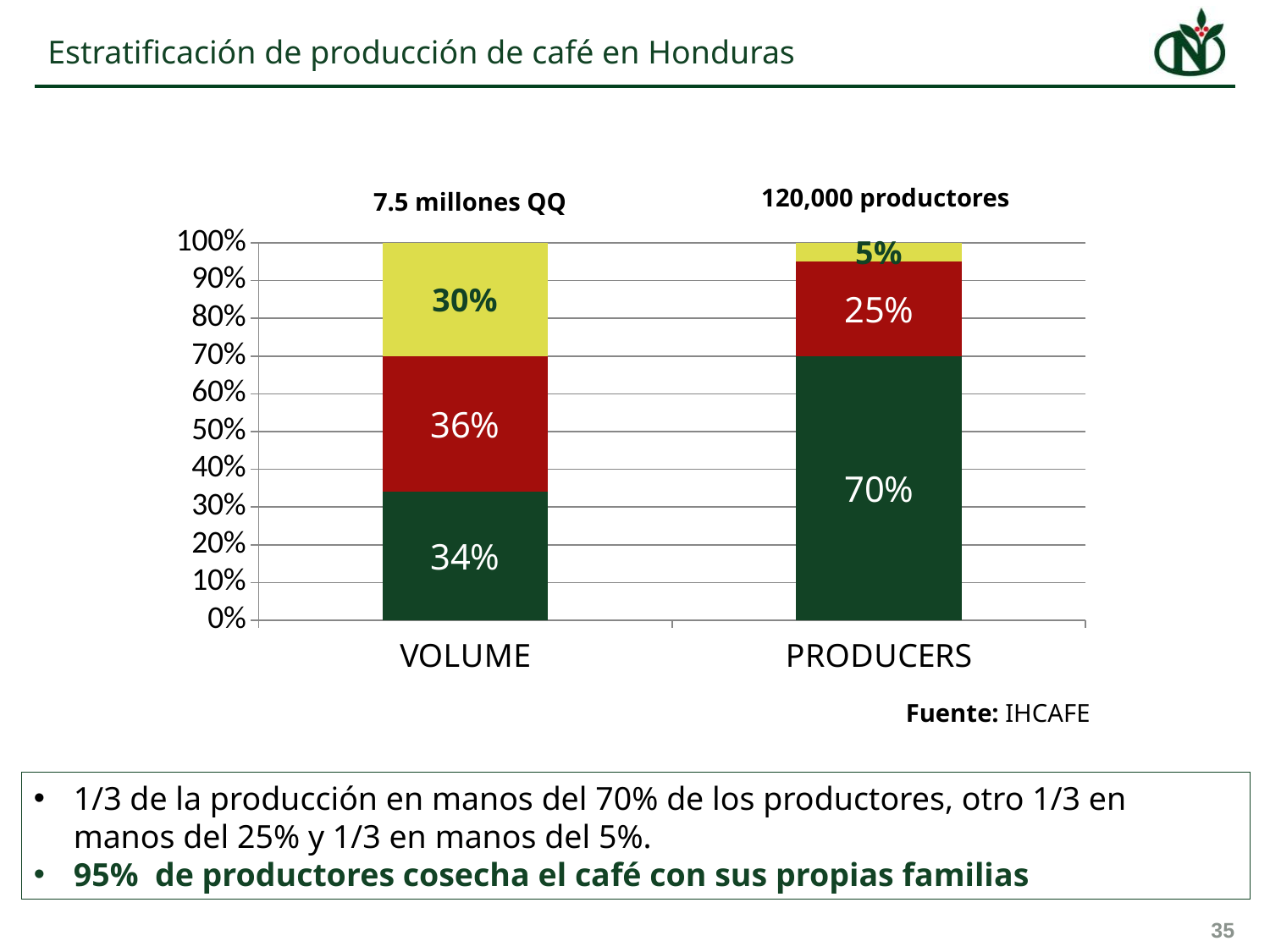
What label is printed above the PRODUCERS bar? 120,000 productores What is the difference between the dark green segment of the PRODUCERS bar and the dark green segment of the VOLUME bar? 36 percentage points What is the value of the bottom (dark green) segment of the PRODUCERS bar? 70% How many categories are shown on the x axis of the chart? 2 What is the total of the stacked VOLUME bar? 100% What is the value of the top (yellow) segment of the VOLUME bar? 30% Which segment of the PRODUCERS bar is the largest? The bottom (dark green) segment, 70% What is the value of the bottom (dark green) segment of the VOLUME bar? 34% What kind of chart is shown on the slide? Stacked bar chart Which is larger: the red segment of the VOLUME bar or the red segment of the PRODUCERS bar? The red segment of the VOLUME bar (36%) What is the value of the middle (red) segment of the VOLUME bar? 36% What is the value of the top (yellow) segment of the PRODUCERS bar? 5%